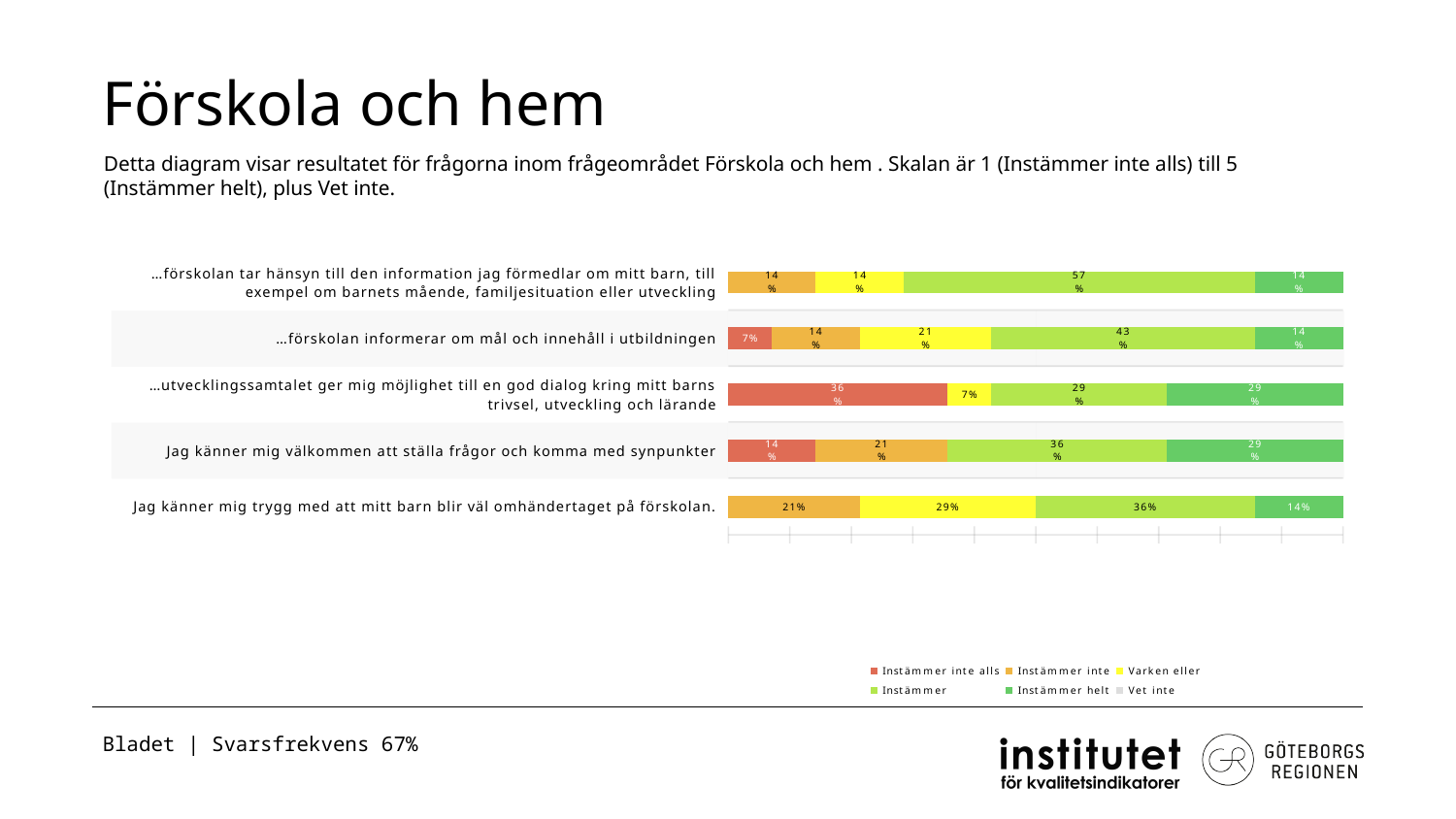
What kind of chart is shown on the slide? bar chart What is the title of the slide containing the chart? Förskola och hem What is the 'Instämmer helt' value for 'Jag känner mig välkommen att ställa frågor och komma med synpunkter'? 29% What is the 'Instämmer' value for '…förskolan tar hänsyn till den information jag förmedlar om mitt barn, till exempel om barnets mående, familjesituation eller utveckling'? 57% Which is larger: the 'Instämmer inte' value for 'Jag känner mig välkommen att ställa frågor och komma med synpunkter' or the 'Instämmer inte' value for '…förskolan informerar om mål och innehåll i utbildningen'? Jag känner mig välkommen att ställa frågor och komma med synpunkter How many question categories are plotted in the chart? 5 What is the difference between the 'Instämmer' value for '…förskolan informerar om mål och innehåll i utbildningen' (43%) and the 'Instämmer' value for 'Jag känner mig trygg med att mitt barn blir väl omhändertaget på förskolan.' (36%)? 7% How many series does the legend list? 6 What is the 'Instämmer inte alls' value for '…utvecklingssamtalet ger mig möjlighet till en god dialog kring mitt barns trivsel, utveckling och lärande'? 36% Which question has the highest 'Instämmer' value? …förskolan tar hänsyn till den information jag förmedlar om mitt barn, till exempel om barnets mående, familjesituation eller utveckling What is the 'Varken eller' value for 'Jag känner mig trygg med att mitt barn blir väl omhändertaget på förskolan.'? 29% What is the 'Instämmer inte alls' value for '…förskolan informerar om mål och innehåll i utbildningen'? 7%